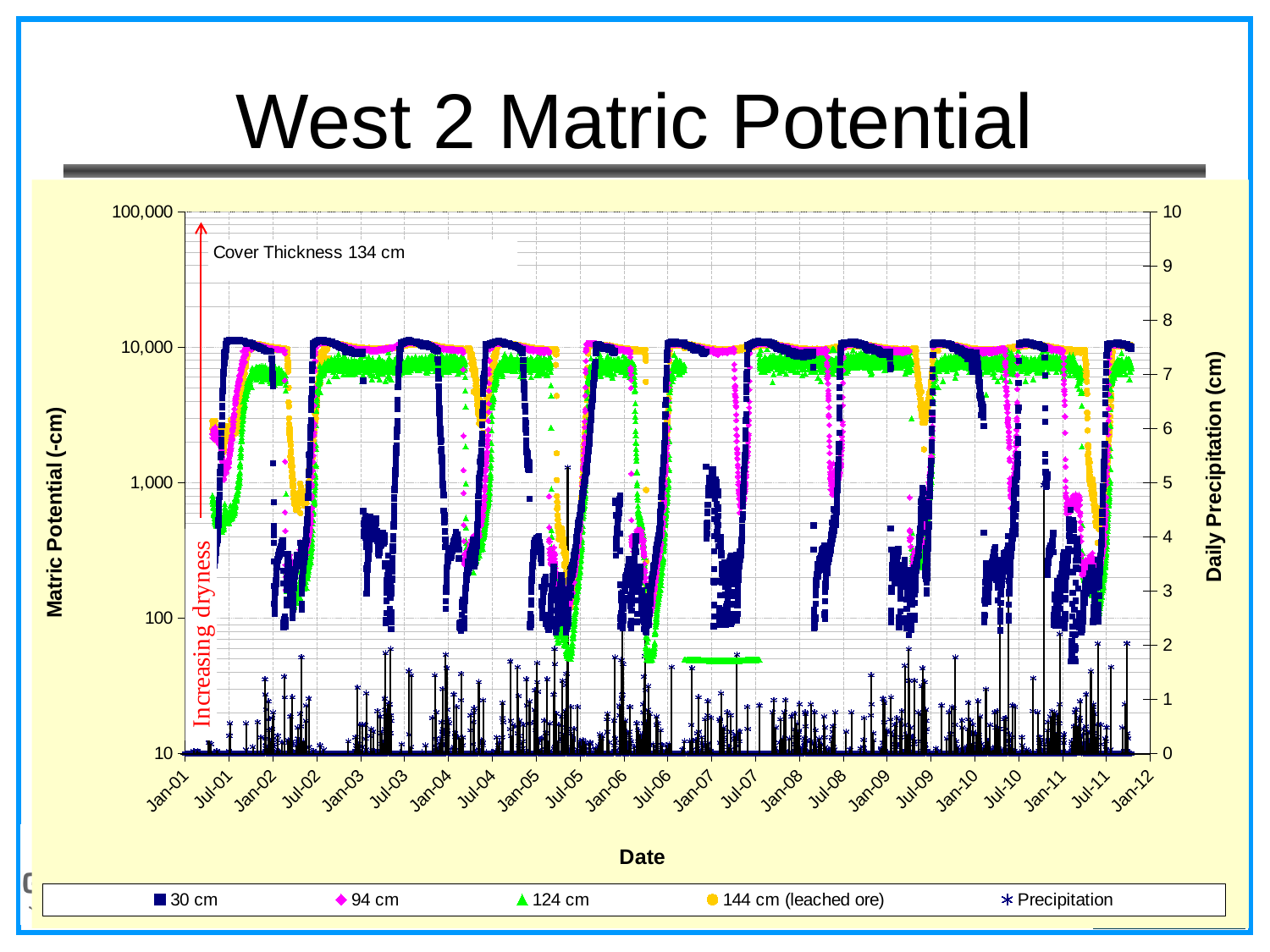
What kind of chart is shown on the slide? scatter chart What is the label of the right vertical axis? Daily Precipitation (cm) Is the value of the 30 cm series around Jul-01 greater or less than 1,000? greater What is the last date label on the x axis? Jan-12 What is the title of the chart? West 2 Matric Potential What is the label of the left vertical axis? Matric Potential (-cm) What is the first date label on the x axis? Jan-01 What is the highest tick value shown on the left vertical axis? 100,000 Is the highest daily precipitation value plotted greater or less than 5? less What cover thickness is noted on the chart? 134 cm How many series does the legend list? 5 What is the highest tick value shown on the right vertical axis? 10